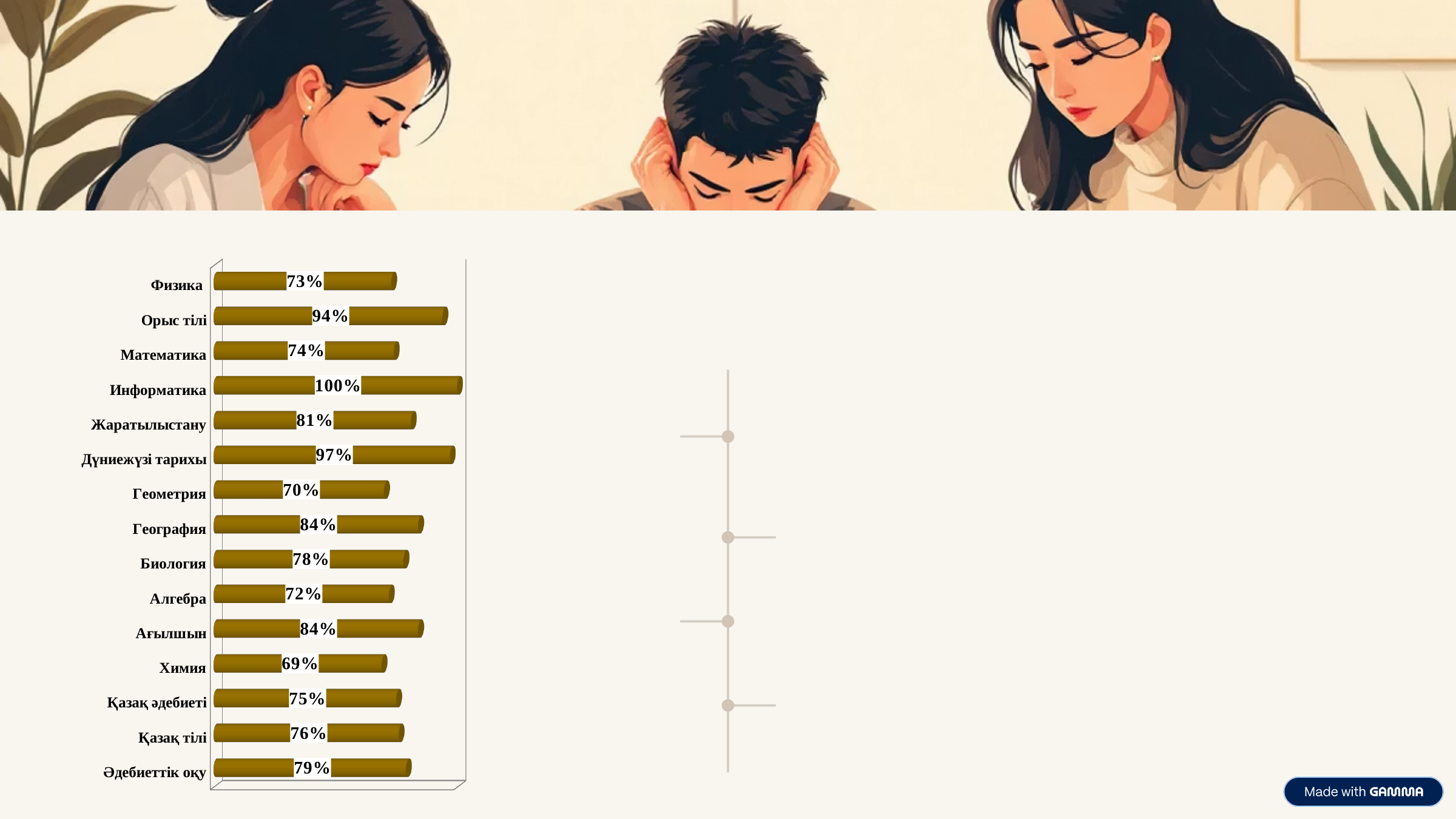
Which is larger, the value for Математика or the value for Әдебиеттік оқу? Әдебиеттік оқу How many categories are shown in the chart? 15 What is the value for Химия? 69% Which is larger, the value for Жаратылыстану or the value for Биология? Жаратылыстану What is the value for Дүниежүзі тарихы? 97% What is the value for Информатика? 100% What kind of chart is shown on the slide? Bar chart What is the value for Қазақ тілі? 76% Which category has the lowest value? Химия Which category has the highest value? Информатика What is the difference between the values for Орыс тілі and Физика? 21% What is the difference between the values for География and Геометрия? 14%